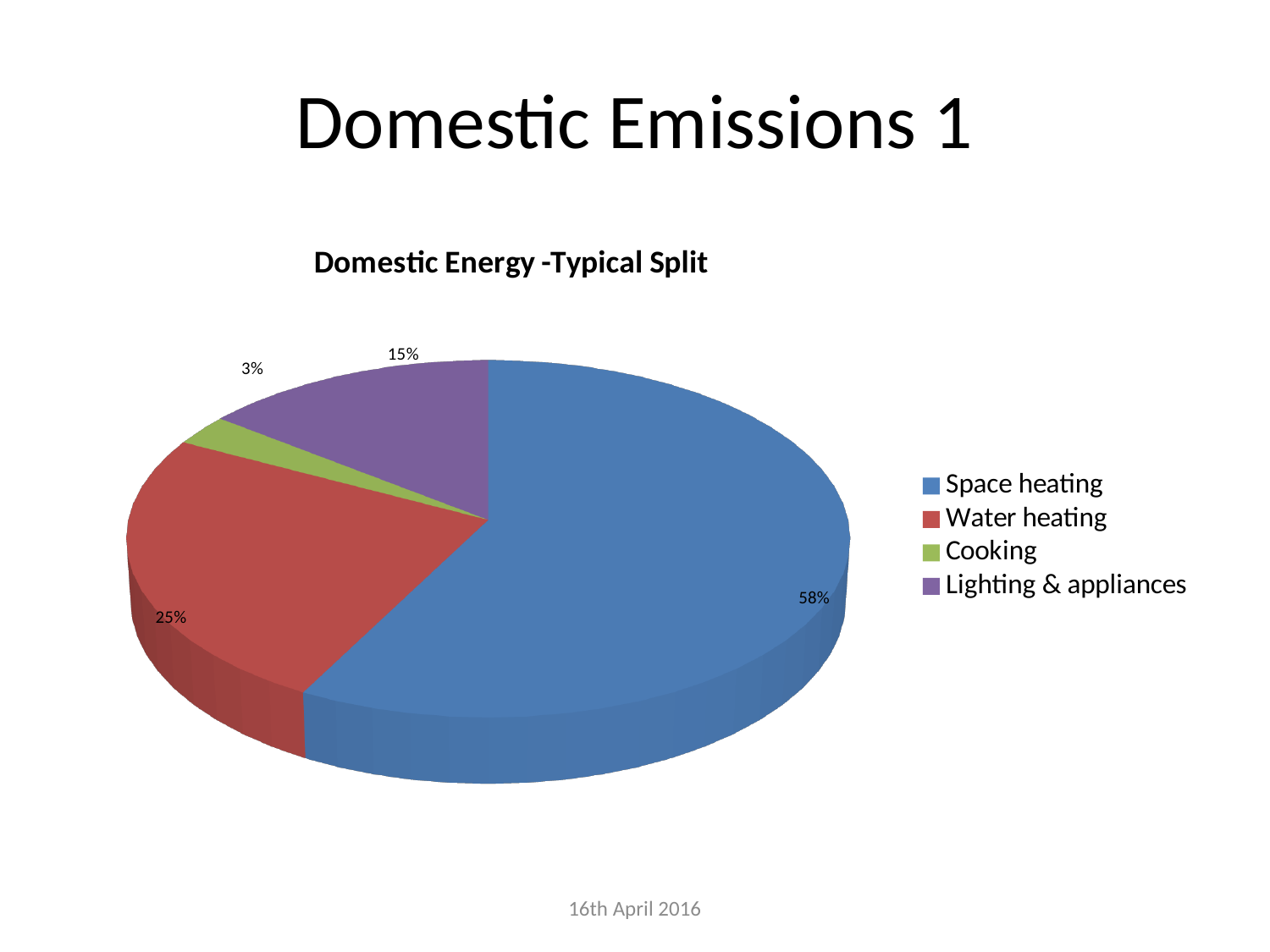
What kind of chart is shown on the slide? Pie chart What is the value shown for Cooking? 3% What share of the pie does Space heating account for? 58% What colour is the Cooking slice in the legend? Green What is the value shown for Lighting & appliances? 15% What is the title of the chart? Domestic Energy -Typical Split How many categories does the pie chart show? 4 Which category has the smallest slice of the pie? Cooking What is the difference between the Space heating and Water heating shares? 33% What is the value shown for Water heating? 25% Which is larger, Water heating or Lighting & appliances? Water heating Which category has the largest slice of the pie? Space heating